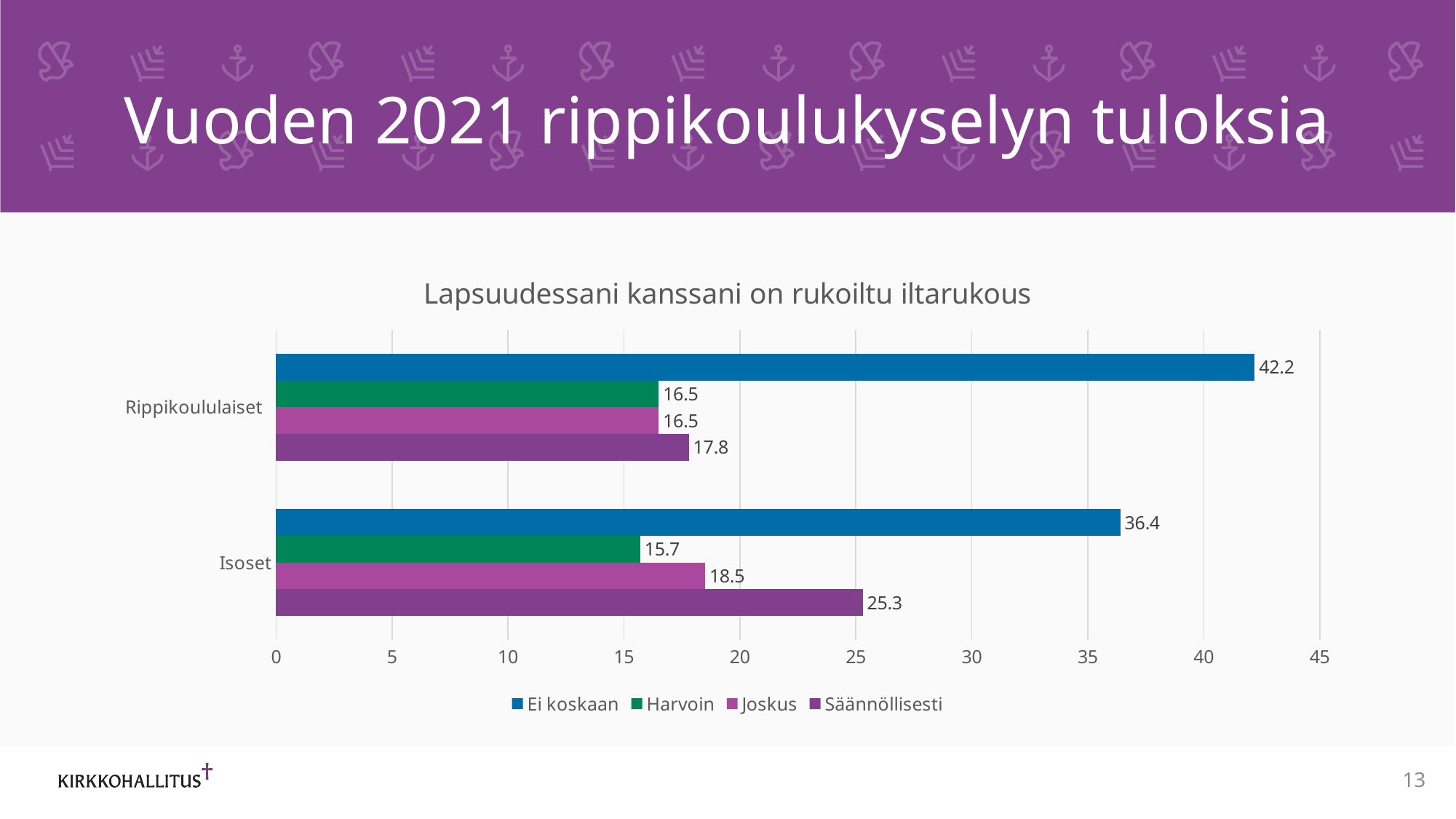
What is the difference between the "Ei koskaan" values for Rippikoululaiset and Isoset? 5.8 What is the value for "Säännöllisesti" for Isoset? 25.3 What is the title of the chart? Lapsuudessani kanssani on rukoiltu iltarukous Which group has the larger value for "Säännöllisesti", Rippikoululaiset or Isoset? Isoset How many series does the legend list? 4 What is the value for "Ei koskaan" for Rippikoululaiset? 42.2 How many categories (groups) are shown on the chart? 2 Which series has the highest value for Isoset? Ei koskaan Which series has the lowest value for Isoset? Harvoin What kind of chart is shown on the slide? Bar chart What is the value for "Joskus" for Isoset? 18.5 What is the value for "Harvoin" for Rippikoululaiset? 16.5